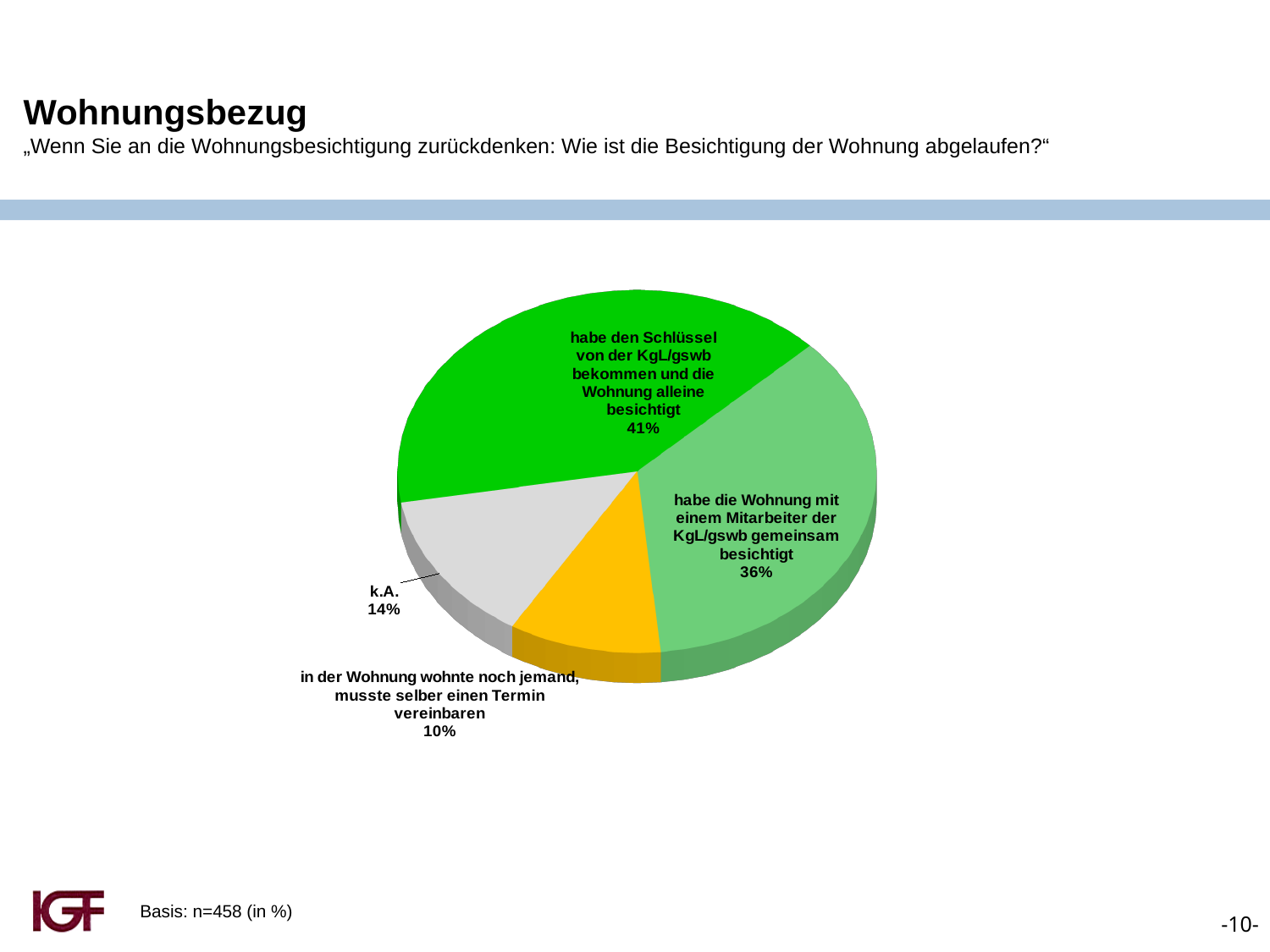
What percentage of respondents said they got the key from KgL/gswb and viewed the apartment alone ("habe den Schlüssel von der KgL/gswb bekommen und die Wohnung alleine besichtigt")? 41% How many slices does the pie chart have? 4 What share is shown for "in der Wohnung wohnte noch jemand, musste selber einen Termin vereinbaren"? 10% What is the base (n) stated for the chart? n=458 What share is shown for "habe die Wohnung mit einem Mitarbeiter der KgL/gswb gemeinsam besichtigt"? 36% What is the combined share of the two largest slices (41% and 36%)? 77% What is the difference in percentage points between viewing the apartment alone (41%) and viewing it together with a KgL/gswb employee (36%)? 5 percentage points What percentage is shown for "k.A."? 14% Which is larger: the share for "k.A." or the share for "in der Wohnung wohnte noch jemand, musste selber einen Termin vereinbaren"? k.A. Which category has the smallest slice of the pie? in der Wohnung wohnte noch jemand, musste selber einen Termin vereinbaren What kind of chart is shown on the slide? pie chart Which category has the largest slice of the pie? habe den Schlüssel von der KgL/gswb bekommen und die Wohnung alleine besichtigt